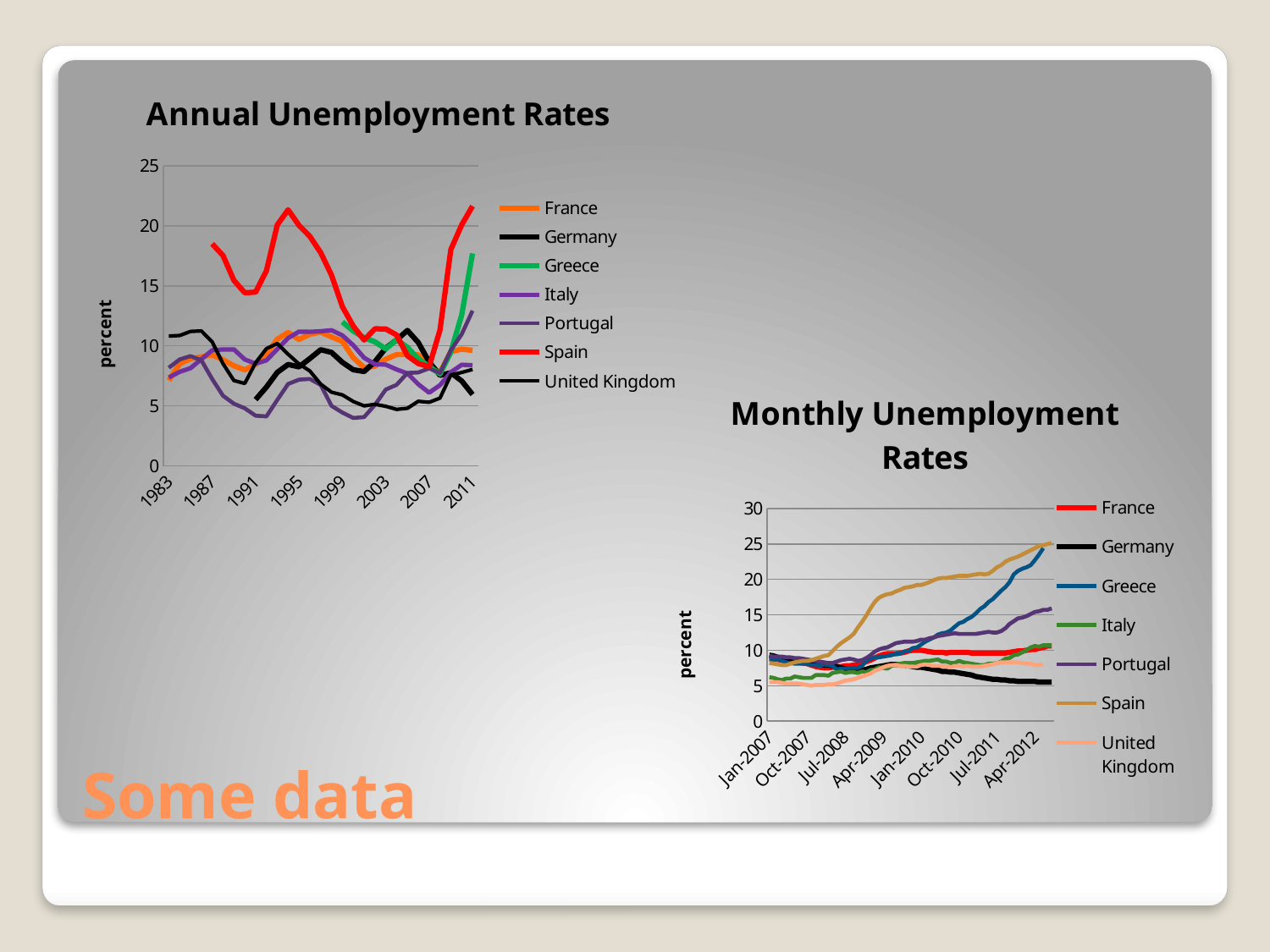
In the Annual Unemployment Rates chart, which country has the highest value in 2011? Spain In the Monthly Unemployment Rates chart, is the value for Germany at Apr-2012 greater or less than 10? less In the Monthly Unemployment Rates chart, is the value for Spain at Apr-2012 greater or less than 20? greater In the Annual Unemployment Rates chart, is the value for Germany in 2011 greater or less than 10? less How many series does the legend of the Monthly Unemployment Rates chart list? 7 What is the label on the vertical axis of the Monthly Unemployment Rates chart? percent What kind of chart is the Annual Unemployment Rates chart? line chart How many series does the legend of the Annual Unemployment Rates chart list? 7 In the Monthly Unemployment Rates chart, does the Greece line rise or fall from Jan-2009 to Apr-2012? rise In the Monthly Unemployment Rates chart, which country has the lowest value at Apr-2012? Germany In the Monthly Unemployment Rates chart, does the Germany line rise or fall from Jan-2007 to Apr-2012? fall